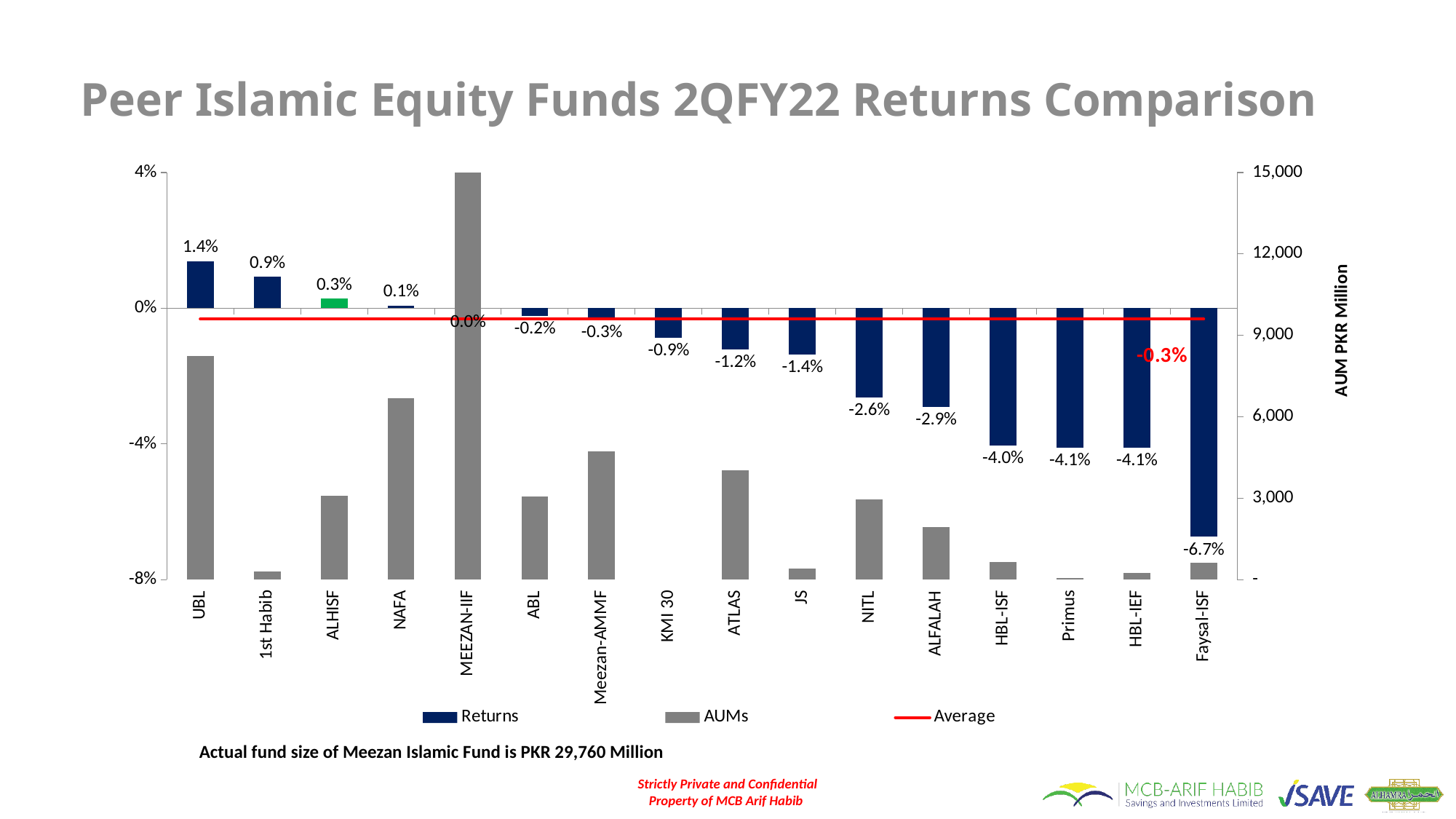
What is the return shown for UBL? 1.4% What is the return shown for ATLAS? -1.2% Which has the higher return, NITL or ALFALAH? NITL What kind of chart is this? combination bar and line chart How many series does the legend list? 3 How many funds are shown on the x axis? 16 Which fund has the lowest return? Faysal-ISF What is the value of the Average line labelled on the chart? -0.3% What is the return shown for Faysal-ISF? -6.7% What is the difference between the returns of UBL and 1st Habib? 0.5% Which fund has the highest return? UBL Is the AUM value for UBL greater or less than 6,000? greater